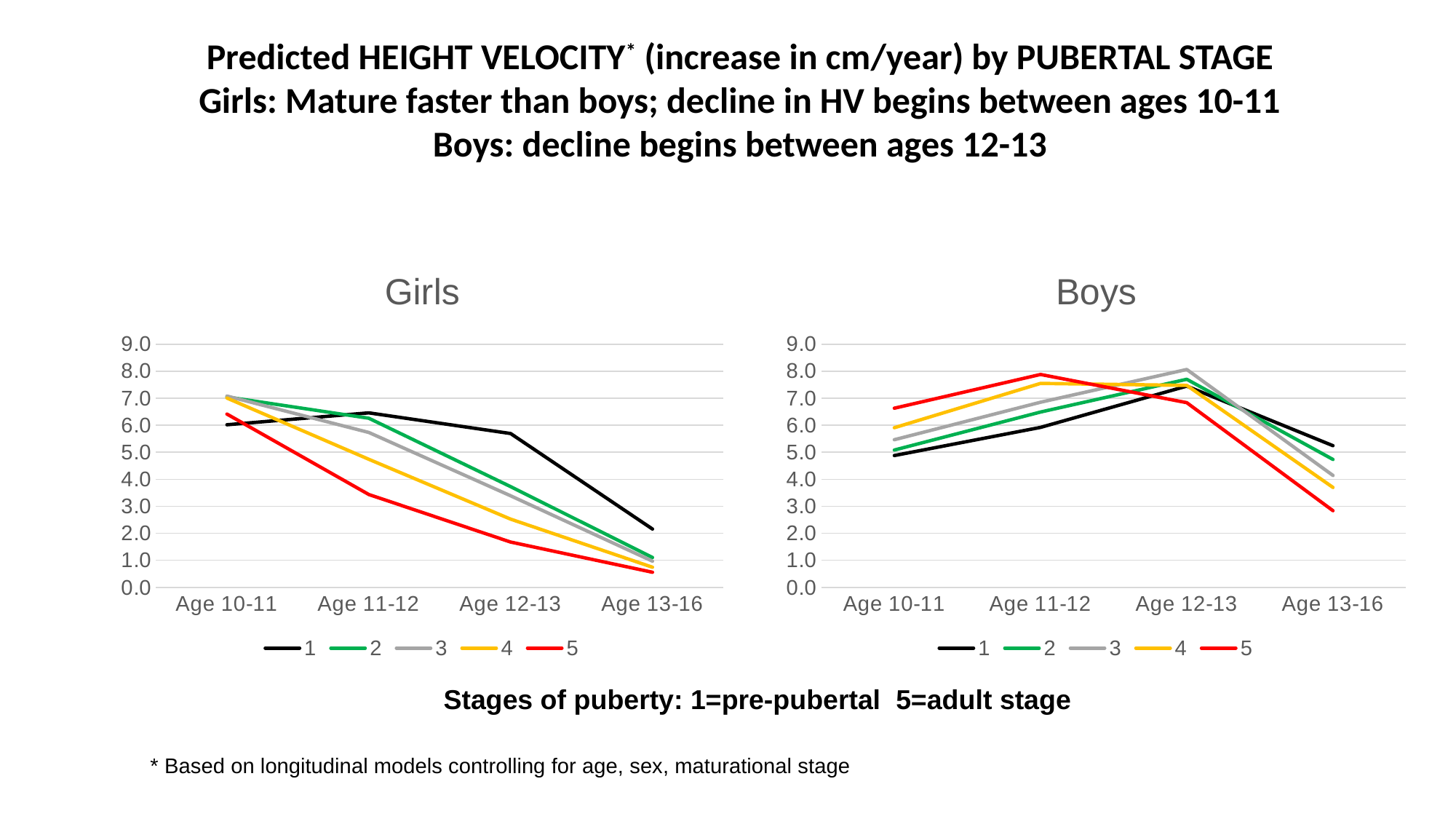
In the Girls chart, which series has the highest value at Age 12-13? 1 What is the title of the chart on the right side of the slide? Boys How many series does the legend of the Girls chart list? 5 In the Girls chart, is the value for series 5 at Age 11-12 greater or less than 4.0? less In the Girls chart, do the values for series 5 rise or fall from Age 10-11 to Age 13-16? fall In the Boys chart, is the value for series 3 at Age 12-13 greater or less than 7.0? greater In the Boys chart, is the value for series 5 at Age 10-11 greater or less than 6.0? greater How many age categories are shown on the x axis of the Boys chart? 4 In the Boys chart, which series has the highest value at Age 10-11? 5 In the Boys chart, which is larger at Age 13-16: series 1 or series 5? series 1 What kind of chart is the Girls chart? line chart